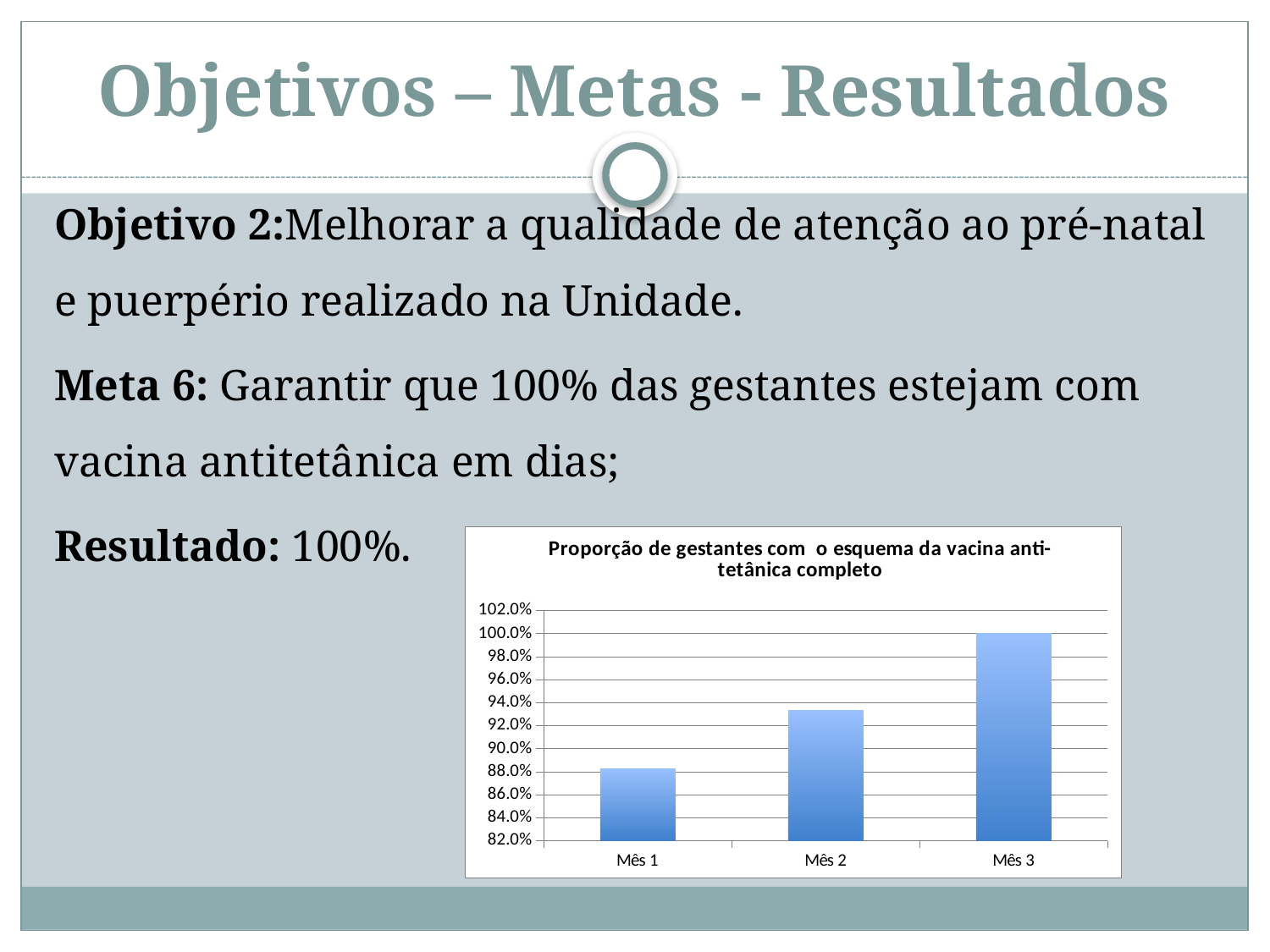
How many categories are plotted on the x axis of the chart? 3 Do the values rise or fall from Mês 1 to Mês 3? rise Is the value for Mês 1 greater or less than 90.0%? less What kind of chart is shown on the slide? bar chart Is the value for Mês 2 greater or less than 92.0%? greater Is the value for Mês 2 greater or less than 96.0%? less Which month has the highest bar in the chart? Mês 3 What is the title of the chart? Proporção de gestantes com o esquema da vacina anti-tetânica completo Which is larger, the value for Mês 1 or the value for Mês 2? Mês 2 Which month has the lowest bar in the chart? Mês 1 What is the value for Mês 3 in the chart? 100.0%